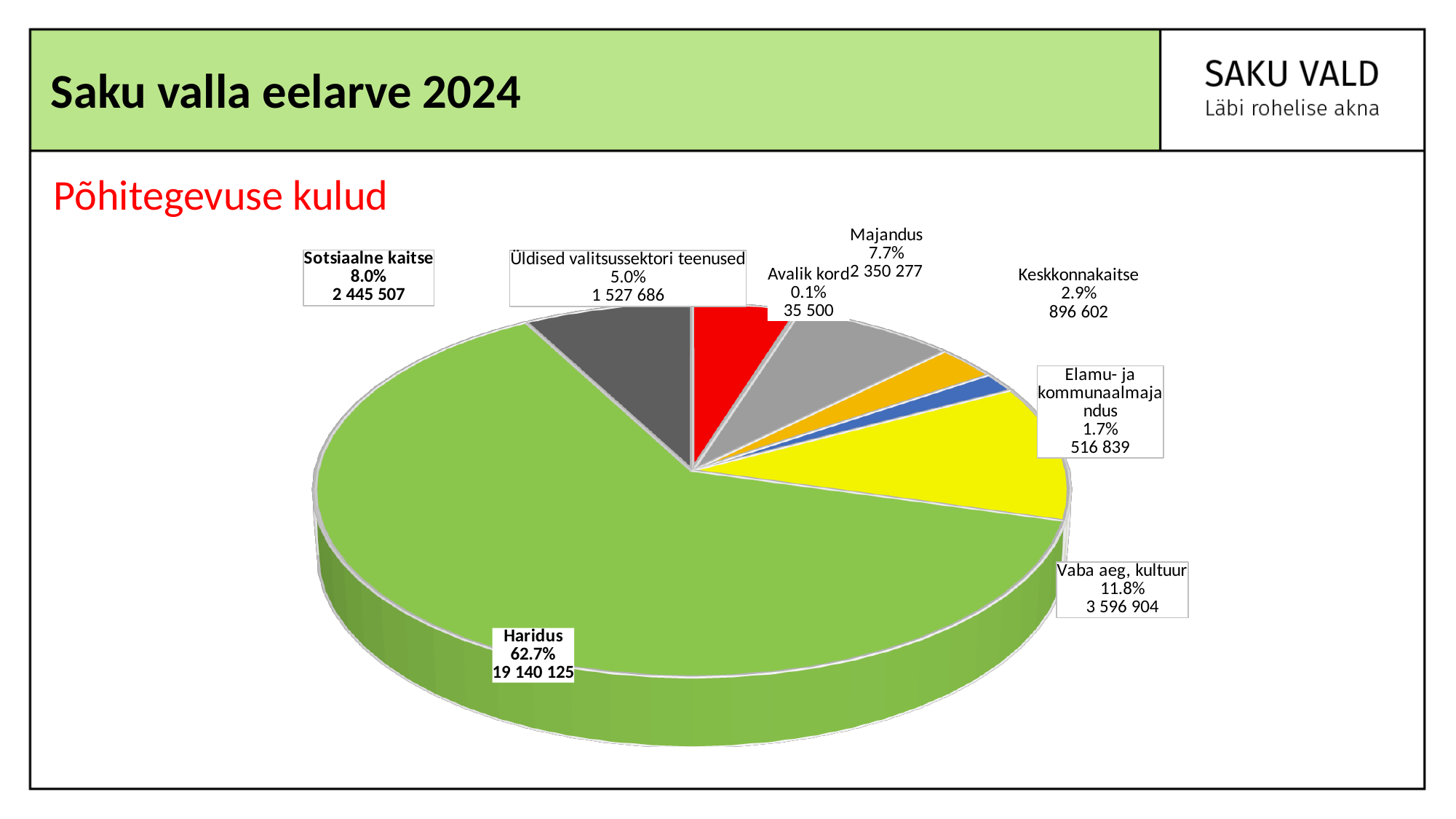
Which category has the smallest slice of the pie? Avalik kord What is the heading written in red above the chart? Põhitegevuse kulud Which is larger, the value for Majandus or the value for Üldised valitsussektori teenused? Majandus What share of the pie does Haridus represent? 62.7% What is the value shown for Keskkonnakaitse? 896 602 What kind of chart is shown on the slide? pie chart What is the difference in percentage points between Sotsiaalne kaitse and Üldised valitsussektori teenused? 3.0% What is the value shown for Sotsiaalne kaitse? 2 445 507 What percentage is shown for Majandus? 7.7% Which category has the largest slice of the pie? Haridus What is the value shown for Vaba aeg, kultuur? 3 596 904 How many categories are shown in the pie chart? 8